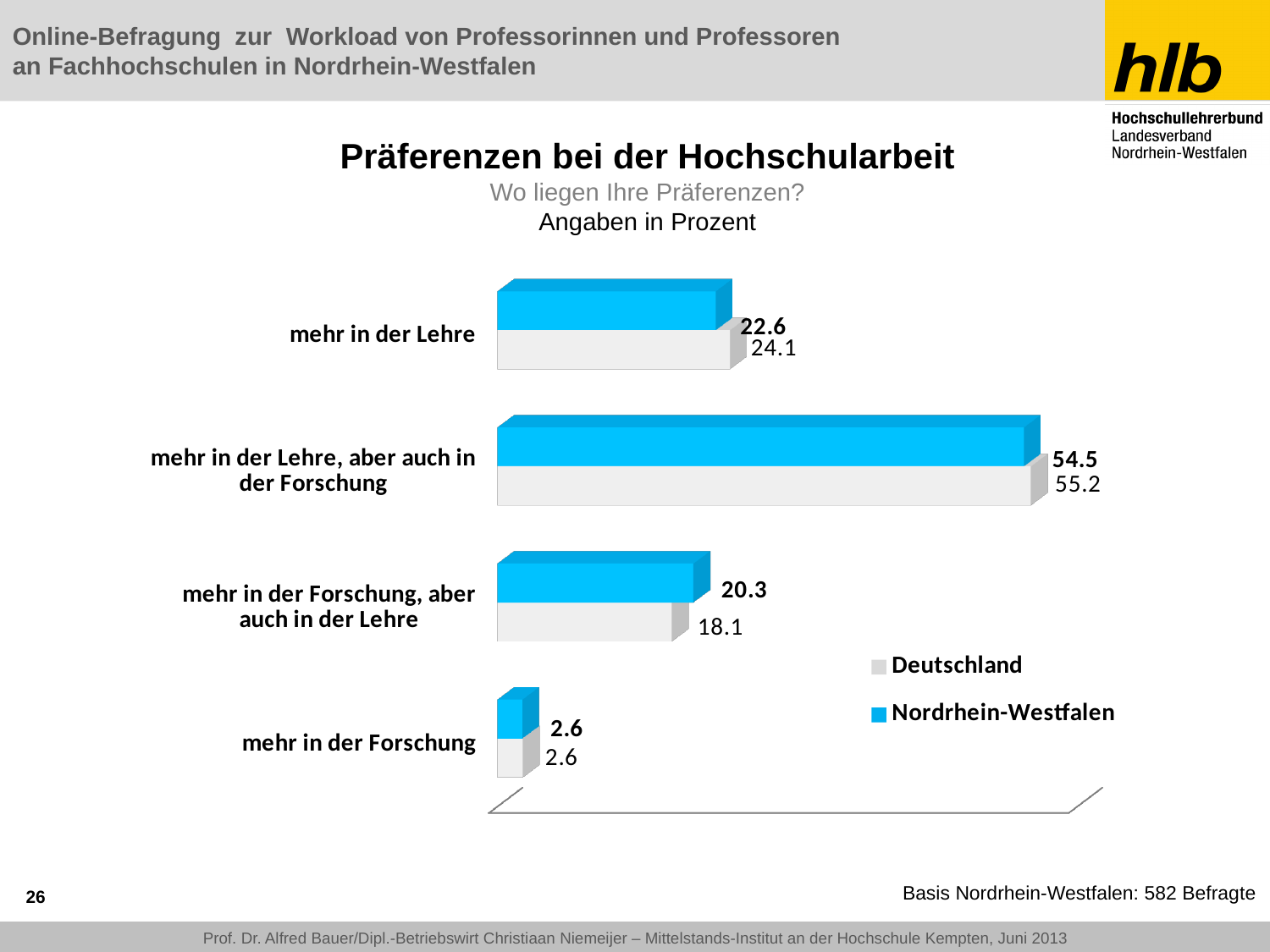
Which category has the lowest value for Deutschland? mehr in der Forschung How many series does the legend list? 2 What is the value for Nordrhein-Westfalen for "mehr in der Forschung"? 2.6 What is the difference between the Deutschland and Nordrhein-Westfalen values for "mehr in der Lehre"? 1.5 What is the value for Deutschland for "mehr in der Lehre, aber auch in der Forschung"? 55.2 How many categories are shown in the chart? 4 What is the value for Nordrhein-Westfalen for "mehr in der Lehre"? 22.6 What is the value for Deutschland for "mehr in der Forschung, aber auch in der Lehre"? 18.1 For "mehr in der Forschung, aber auch in der Lehre", which is larger: Deutschland or Nordrhein-Westfalen? Nordrhein-Westfalen What kind of chart is shown on the slide? bar chart Which category has the highest value for Nordrhein-Westfalen? mehr in der Lehre, aber auch in der Forschung What is the title of the chart? Präferenzen bei der Hochschularbeit